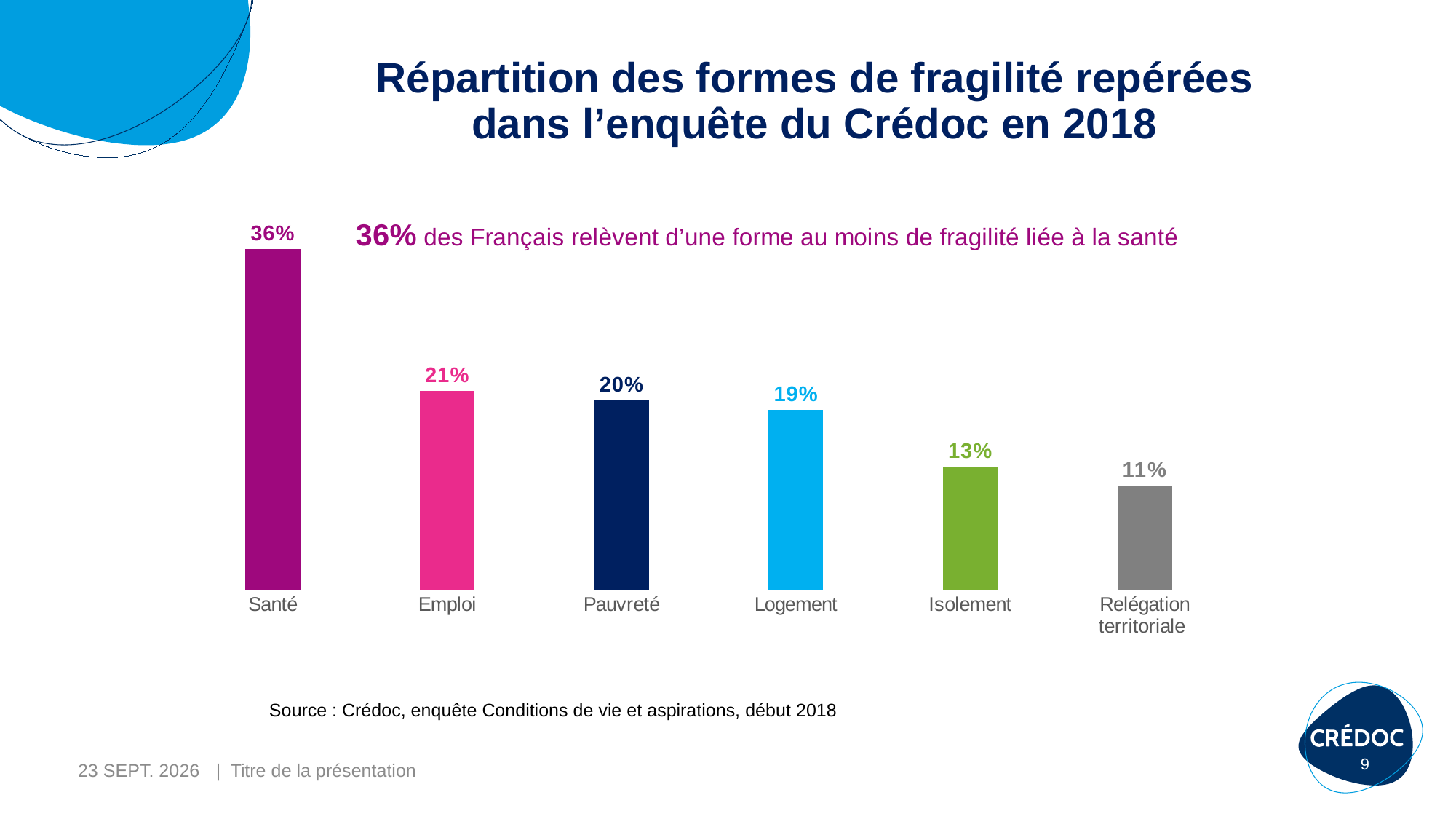
Do the values rise or fall from left to right along the x axis? Fall What is the value for Logement? 19% What kind of chart is shown on the slide? Bar chart What is the difference between the values for Santé and Pauvreté? 16% What is the value for Relégation territoriale? 11% What is the value for Emploi? 21% What is the difference between the values for Isolement and Relégation territoriale? 2% Which is larger, the value for Emploi or the value for Isolement? Emploi Which category has the highest value? Santé How many categories are shown in the chart? 6 What is the value for Santé? 36% Which category has the lowest value? Relégation territoriale